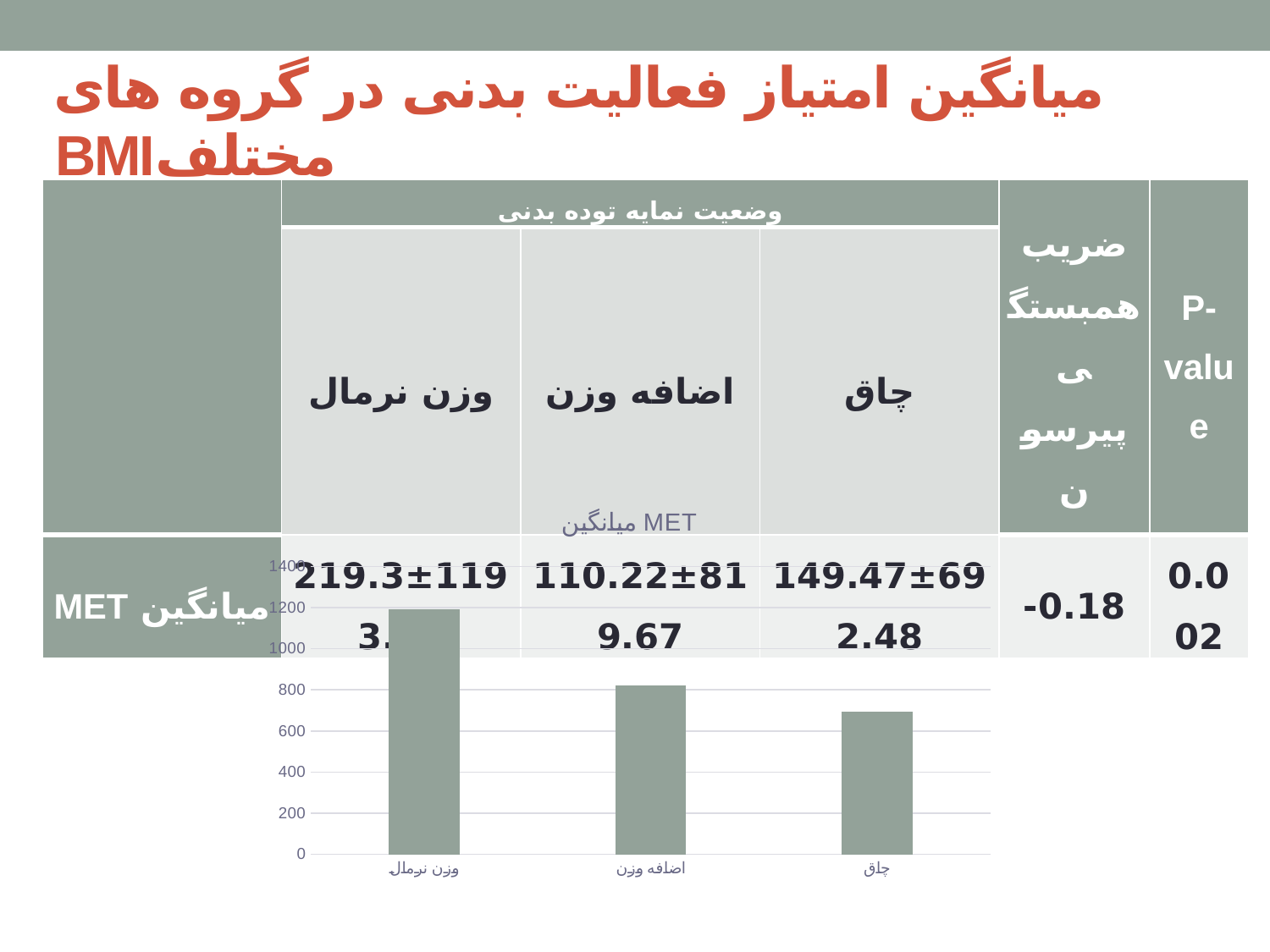
What kind of chart is shown on the slide? bar chart Is the value for چاق greater or less than 600? greater Is the value for وزن نرمال greater or less than 1000? greater Which category has the lowest bar in the chart? چاق Which is larger in the chart, the value for وزن نرمال or the value for اضافه وزن? وزن نرمال How many categories are plotted on the x axis of the chart? 3 Is the value for اضافه وزن greater or less than 1000? less Which category has the highest bar in the chart? وزن نرمال Do the bar values rise or fall from left to right along the x axis? fall What is the title of the chart? میانگین MET Which is larger in the chart, the value for اضافه وزن or the value for چاق? اضافه وزن